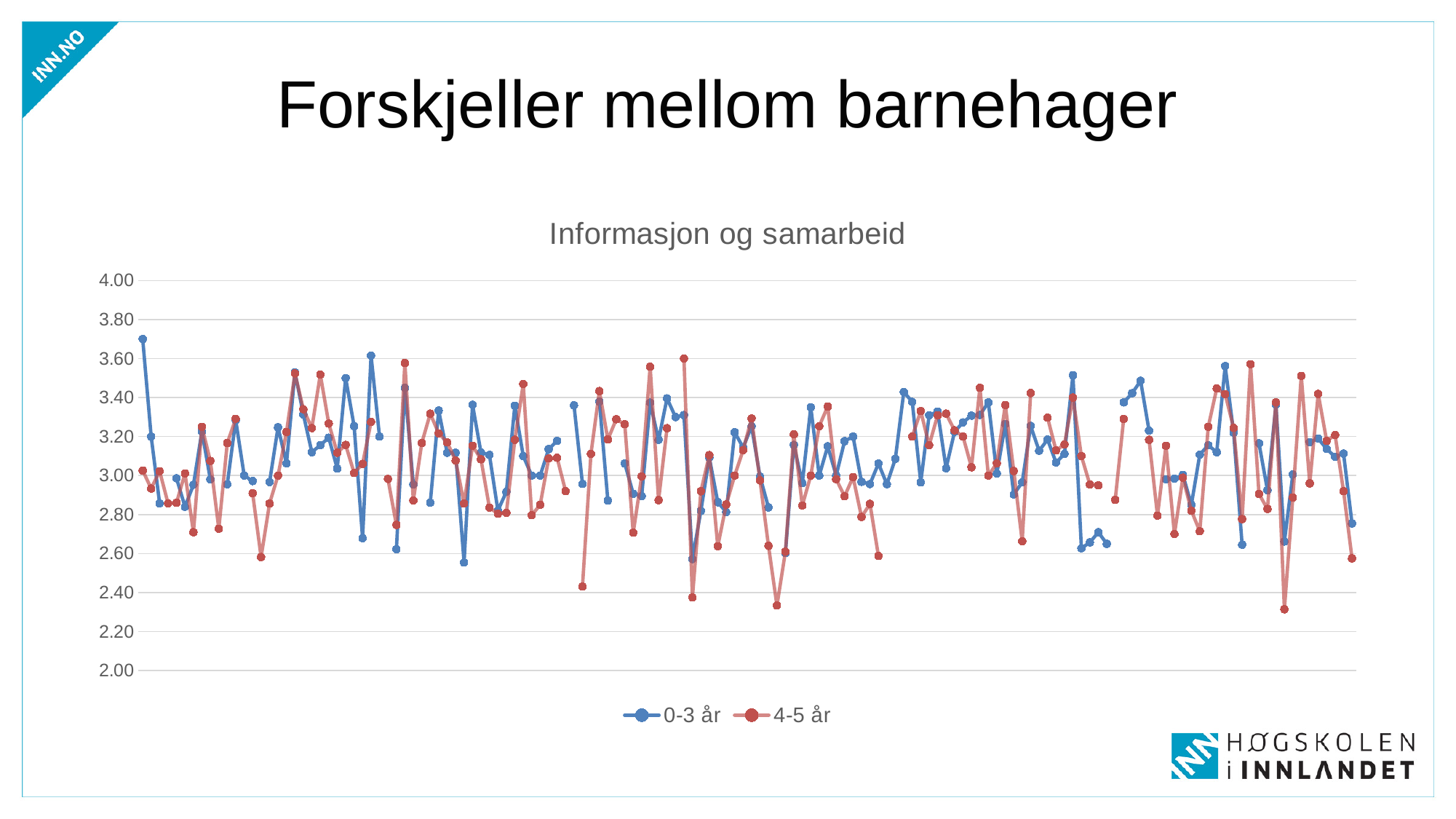
Is the lowest point of the 0-3 år series greater or less than 2.80? less How many series does the legend list? 2 What is the highest value shown on the vertical axis? 4.00 Which series reaches the highest value anywhere on the chart, 0-3 år or 4-5 år? 0-3 år Which series reaches the lowest value anywhere on the chart, 0-3 år or 4-5 år? 4-5 år What are the two series named in the legend? 0-3 år and 4-5 år What kind of chart is shown on the slide? line chart Is the lowest point of the 4-5 år series greater or less than 2.40? less What is the interval between consecutive tick marks on the vertical axis? 0.20 What is the title of the chart? Informasjon og samarbeid What is the lowest value shown on the vertical axis? 2.00 Is the highest point of the 0-3 år series greater or less than 3.60? greater